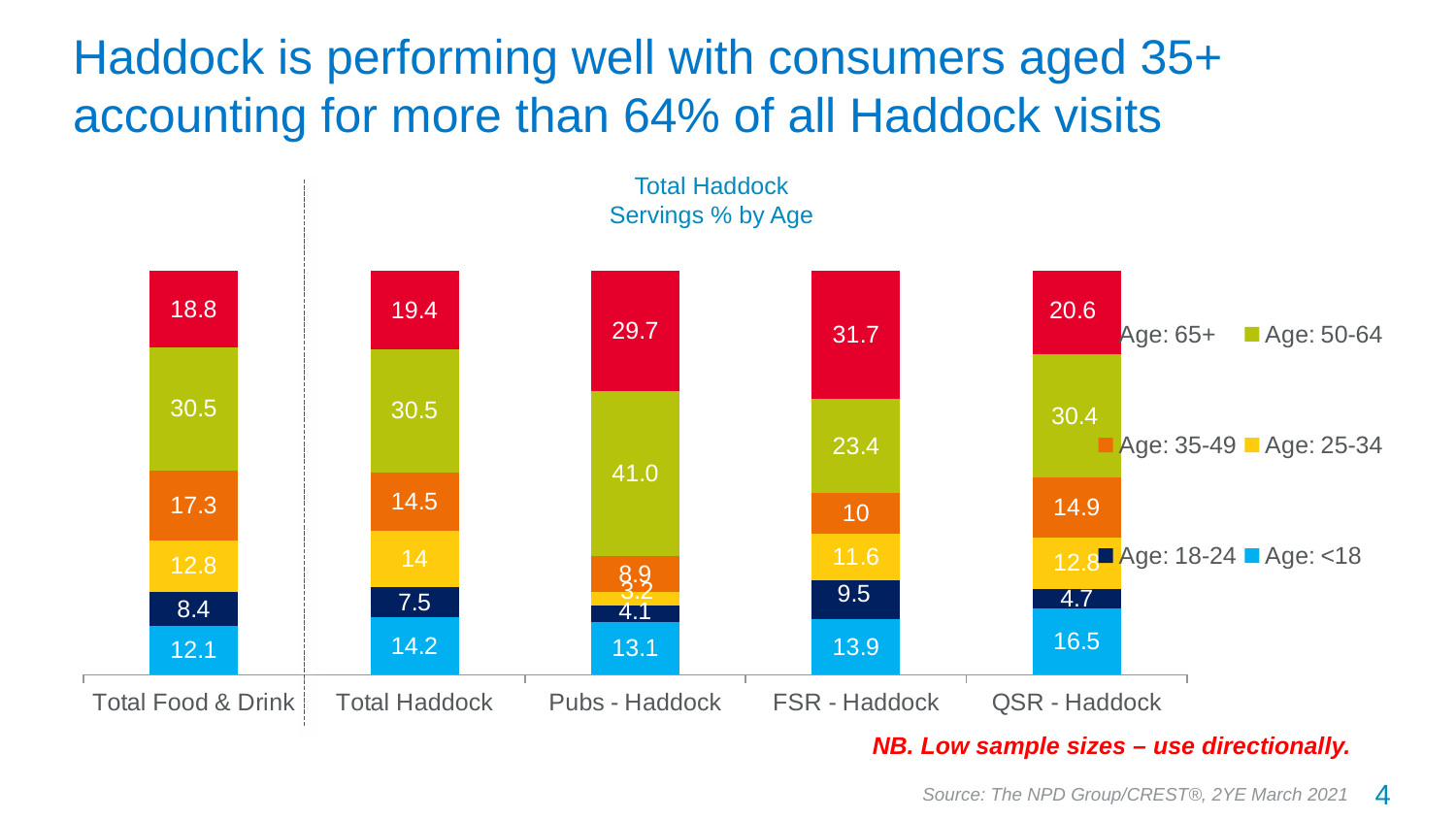
What is the Age: <18 value for QSR - Haddock? 16.5 What is the Age: 65+ value for FSR - Haddock? 31.7 Which category has the lowest Age: 18-24 value? Pubs - Haddock What kind of chart is shown on the slide? Stacked bar chart What is the Age: 50-64 value for Pubs - Haddock? 41.0 Which has the larger Age: 35-49 value, Total Food & Drink or Total Haddock? Total Food & Drink How many categories are shown along the x axis of the chart? 5 Which category has the highest Age: 65+ value? FSR - Haddock How many age series does the legend list? 6 What is the Age: 25-34 value for Total Haddock? 14 How much larger is the Age: 50-64 value for Pubs - Haddock than for Total Haddock? 10.5 What is the title of the chart? Total Haddock Servings % by Age